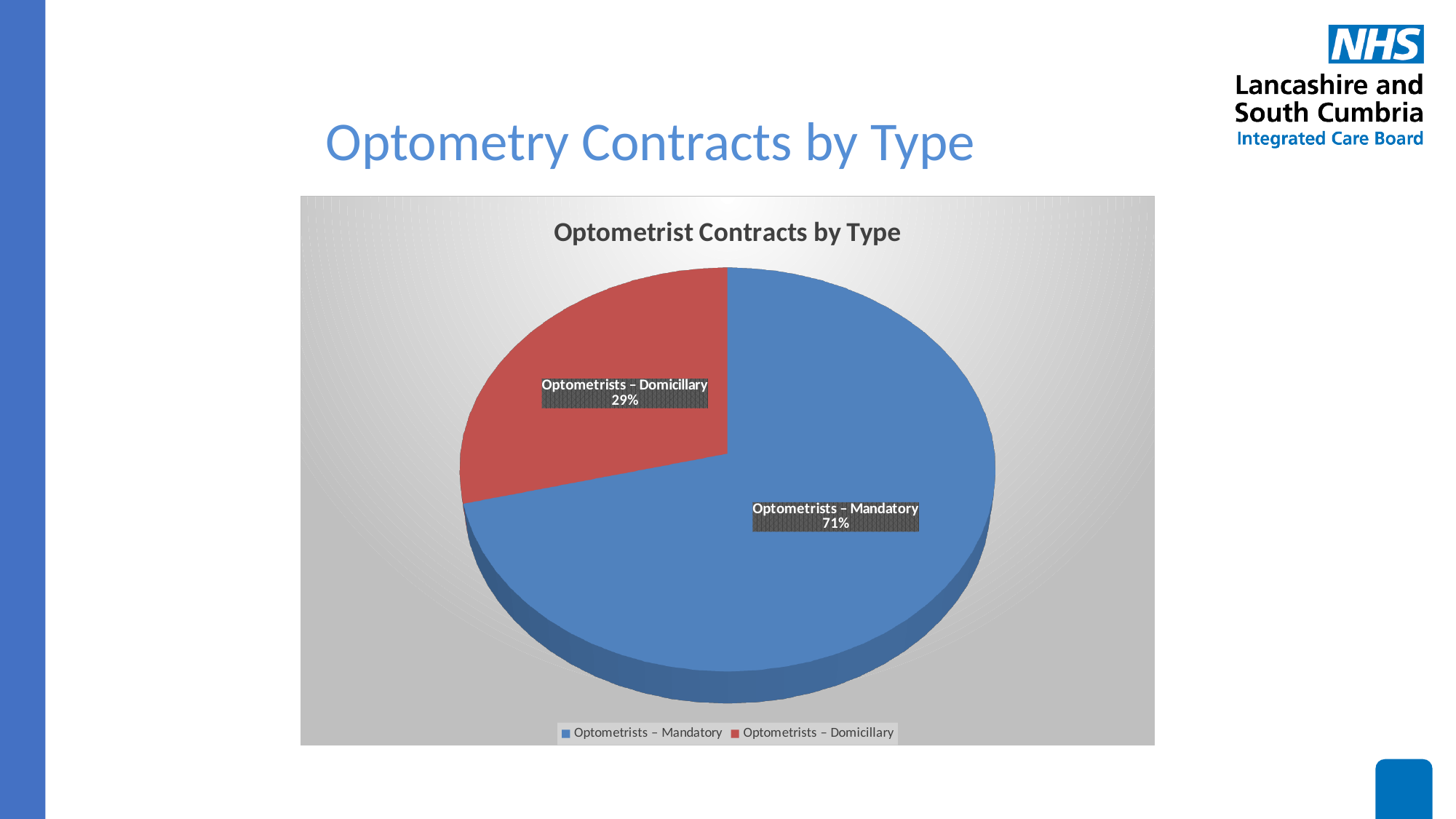
What is the chart's title? Optometrist Contracts by Type What percentage of contracts are Optometrists – Mandatory? 71% What percentage of contracts are Optometrists – Domicillary? 29% What colour is the Optometrists – Domicillary slice? Red Which contract type has the largest share of the pie? Optometrists – Mandatory What share of the pie does the Optometrists – Mandatory slice represent? 71% How many entries does the legend list? 2 What type of chart is shown on the slide? Pie chart How many slices does the pie chart have? 2 What is the difference in percentage points between the Mandatory and Domicillary shares? 42 Which contract type has the smallest share of the pie? Optometrists – Domicillary Which is larger, the share for Optometrists – Mandatory or Optometrists – Domicillary? Optometrists – Mandatory